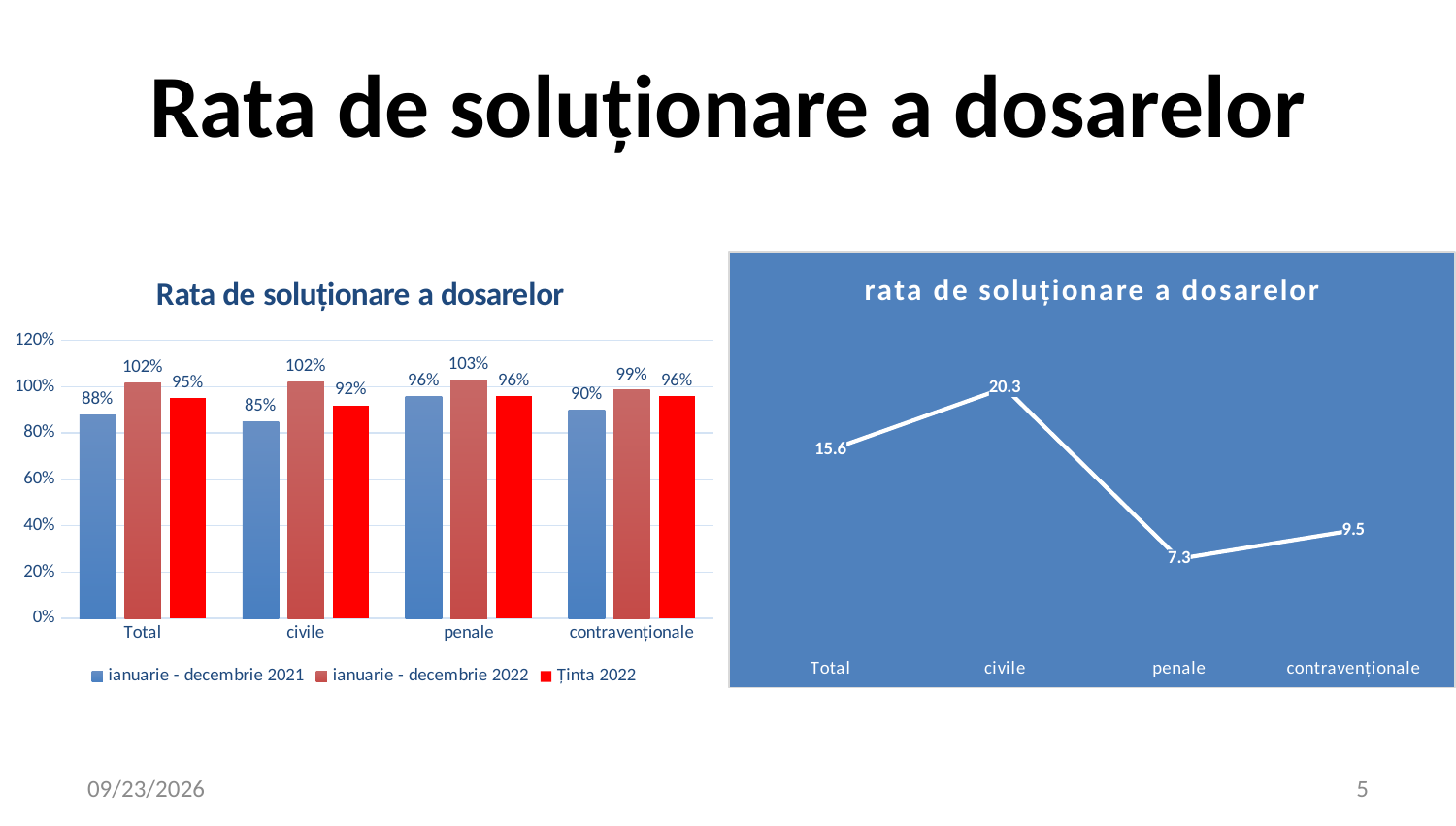
How many categories are shown on the x axis of the right line chart? 4 In the right line chart, what is the value for 'civile'? 20.3 In the right line chart, which category has the lowest value? penale What kind of chart is the chart on the right side of the slide? line chart How many series does the legend of the left bar chart list? 3 In the left bar chart, what is the value for 'Total' in the 'ianuarie - decembrie 2021' series? 88% In the left bar chart, what is the difference between the 'ianuarie - decembrie 2022' value and the 'ianuarie - decembrie 2021' value for 'civile'? 17% In the right line chart, what is the difference between the values for 'Total' and 'penale'? 8.3 In the left bar chart, which category has the lowest value in the 'ianuarie - decembrie 2021' series? civile In the left bar chart, which is larger for 'contravenționale': the 'ianuarie - decembrie 2022' value or the 'Ținta 2022' value? ianuarie - decembrie 2022 In the left bar chart, what is the 'Ținta 2022' value for 'penale'? 96% In the left bar chart, what is the value for 'civile' in the 'ianuarie - decembrie 2022' series? 102%